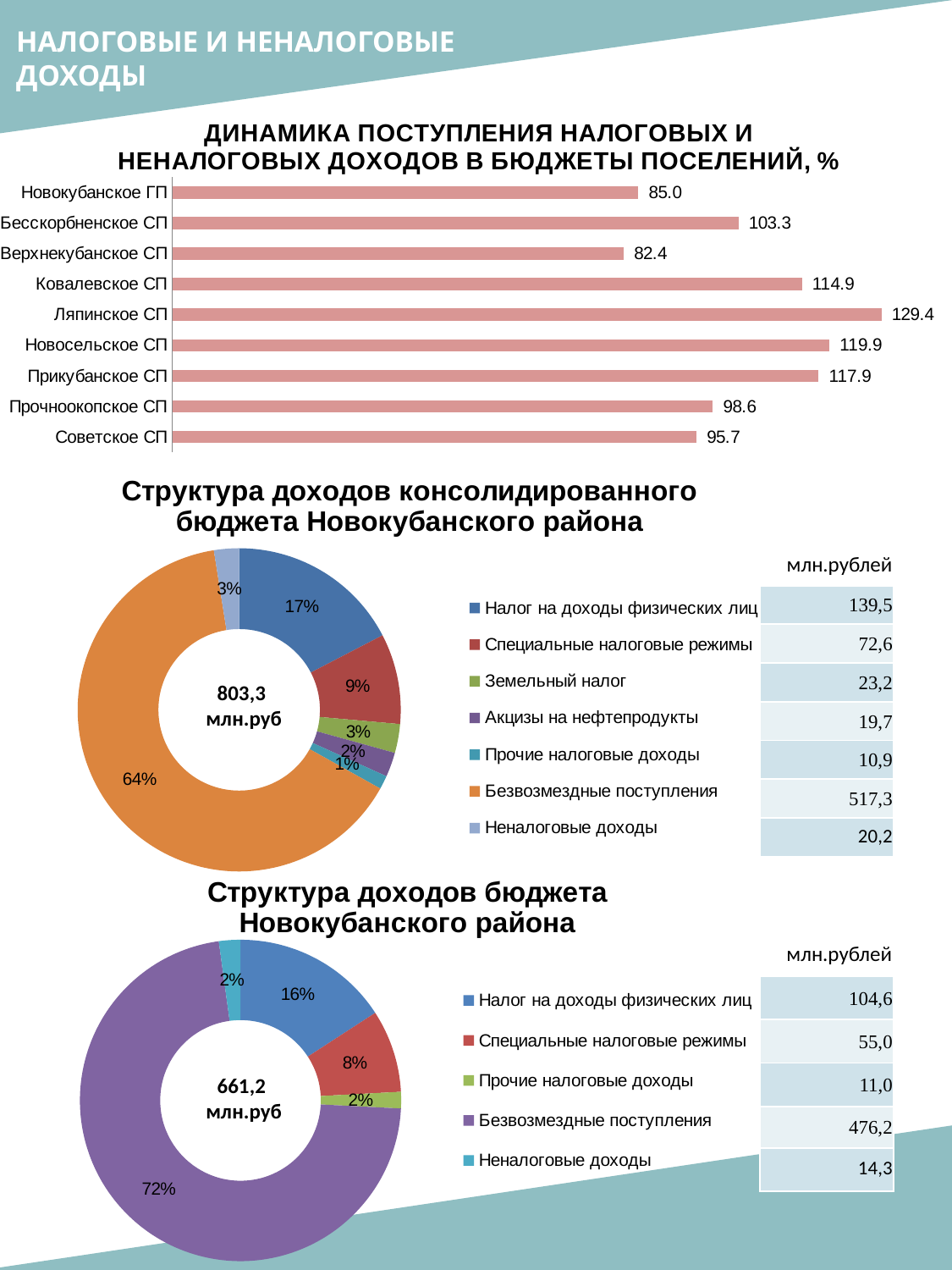
In the chart 'Структура доходов бюджета Новокубанского района', what is the value in млн.рублей for 'Безвозмездные поступления'? 476,2 In the bar chart 'Динамика поступления налоговых и неналоговых доходов в бюджеты поселений, %', what is the difference between the values for Ляпинское СП and Верхнекубанское СП? 47.0 How many settlements are shown in the bar chart 'Динамика поступления налоговых и неналоговых доходов в бюджеты поселений, %'? 9 What type of chart is 'Динамика поступления налоговых и неналоговых доходов в бюджеты поселений, %'? bar chart In the bar chart 'Динамика поступления налоговых и неналоговых доходов в бюджеты поселений, %', what is the value for Ляпинское СП? 129.4 In the bar chart 'Динамика поступления налоговых и неналоговых доходов в бюджеты поселений, %', which settlement has the highest value? Ляпинское СП In the bar chart 'Динамика поступления налоговых и неналоговых доходов в бюджеты поселений, %', which settlement has the lowest value? Верхнекубанское СП What total is shown in the centre of the doughnut chart 'Структура доходов бюджета Новокубанского района'? 661,2 млн.руб In the bar chart 'Динамика поступления налоговых и неналоговых доходов в бюджеты поселений, %', which is larger: the value for Новосельское СП or Прикубанское СП? Новосельское СП How many categories does the legend list in the chart 'Структура доходов консолидированного бюджета Новокубанского района'? 7 In the chart 'Структура доходов консолидированного бюджета Новокубанского района', what share does 'Безвозмездные поступления' have? 64% In the chart 'Структура доходов консолидированного бюджета Новокубанского района', what is the value in млн.рублей for 'Налог на доходы физических лиц'? 139,5